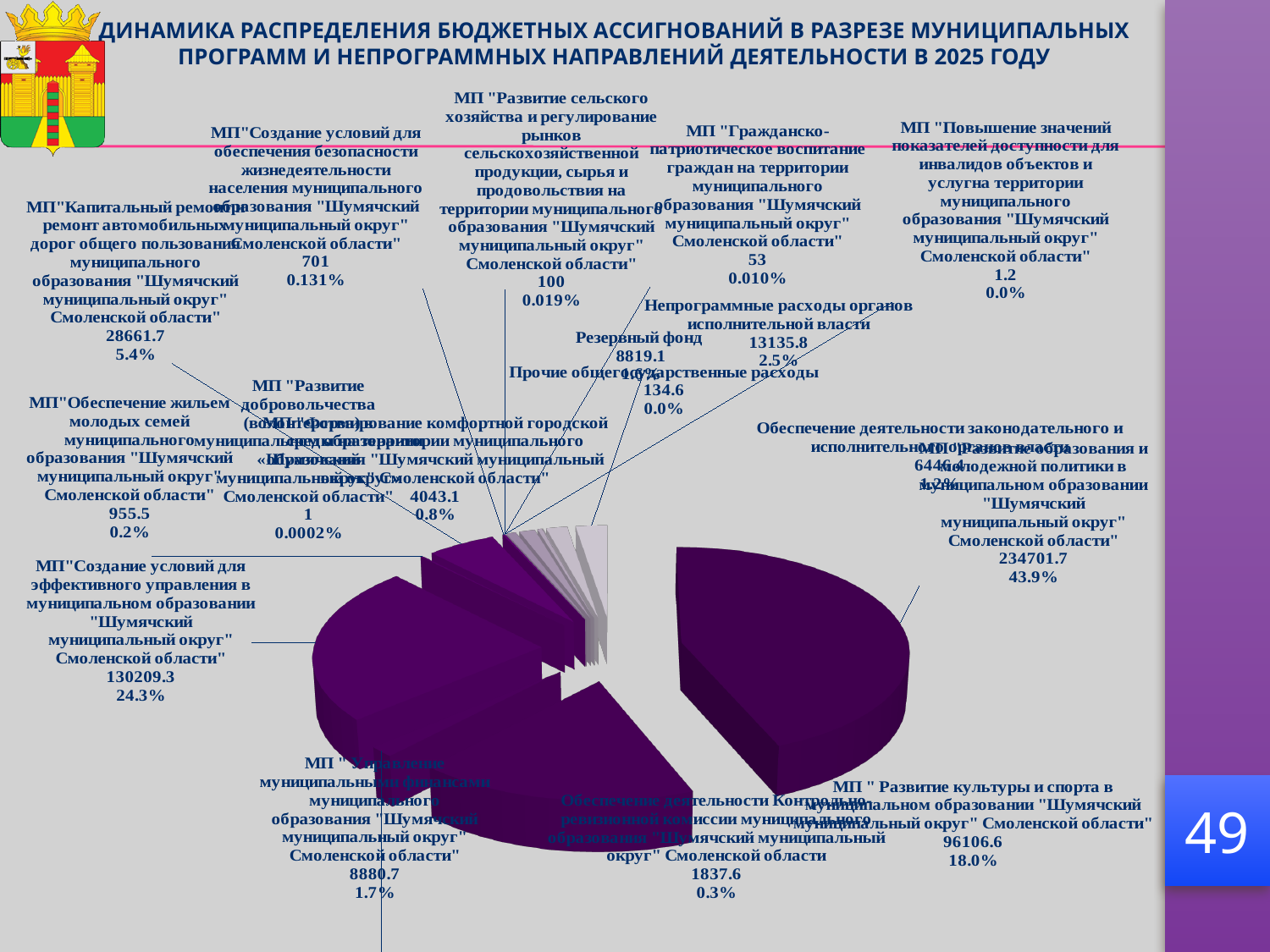
What kind of chart is shown on the slide? pie chart What is the difference between the values for МП "Развитие образования и молодежной политики" (234701.7) and МП "Создание условий для эффективного управления" (130209.3)? 104492.4 Which category has the largest share of the pie? МП "Развитие образования и молодежной политики" What is the value shown for МП "Создание условий для эффективного управления в муниципальном образовании"? 130209.3 What share of the budget goes to МП "Развитие образования и молодежной политики"? 43.9% What percentage is shown for МП "Развитие культуры и спорта"? 18.0% Which category has the smallest value on the chart? МП "Развитие добровольчества (волонтерства)" What year does the chart title refer to? 2025 What is the value shown for МП "Капитальный ремонт, ремонт автомобильных дорог общего пользования"? 28661.7 What value is shown for Непрограммные расходы органов исполнительной власти? 13135.8 What percentage is shown for Обеспечение деятельности Контрольно-ревизионной комиссии? 0.3% Which is larger: the value for МП "Развитие культуры и спорта" or for МП "Капитальный ремонт, ремонт автомобильных дорог"? МП "Развитие культуры и спорта"